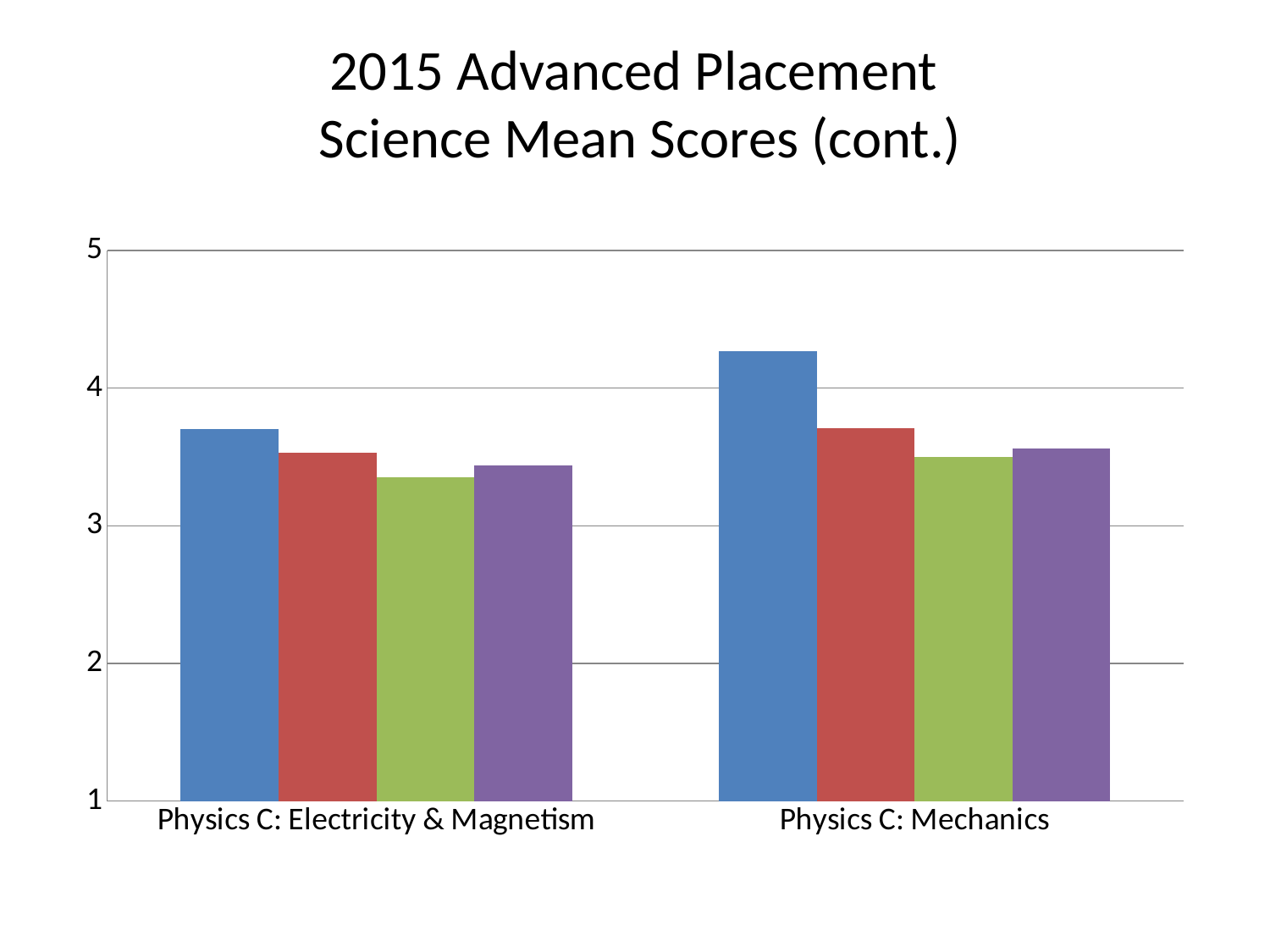
Is the value of the blue bar for Physics C: Mechanics greater or less than 4? greater What kind of chart is shown on the slide? bar chart Which colour bar is the tallest within the Physics C: Mechanics category? blue Is the blue bar larger for Physics C: Mechanics or for Physics C: Electricity & Magnetism? Physics C: Mechanics Is the value of the green bar for Physics C: Electricity & Magnetism greater or less than 3? greater Which colour bar is the shortest within the Physics C: Electricity & Magnetism category? green Which category has the tallest bar in the chart? Physics C: Mechanics How many categories are shown on the x axis of the chart? 2 Within Physics C: Mechanics, is the red bar or the green bar larger? red How many bars are plotted for each category in the chart? 4 What is the title of the chart on the slide? 2015 Advanced Placement Science Mean Scores (cont.) Is the value of the blue bar for Physics C: Electricity & Magnetism greater or less than 4? less